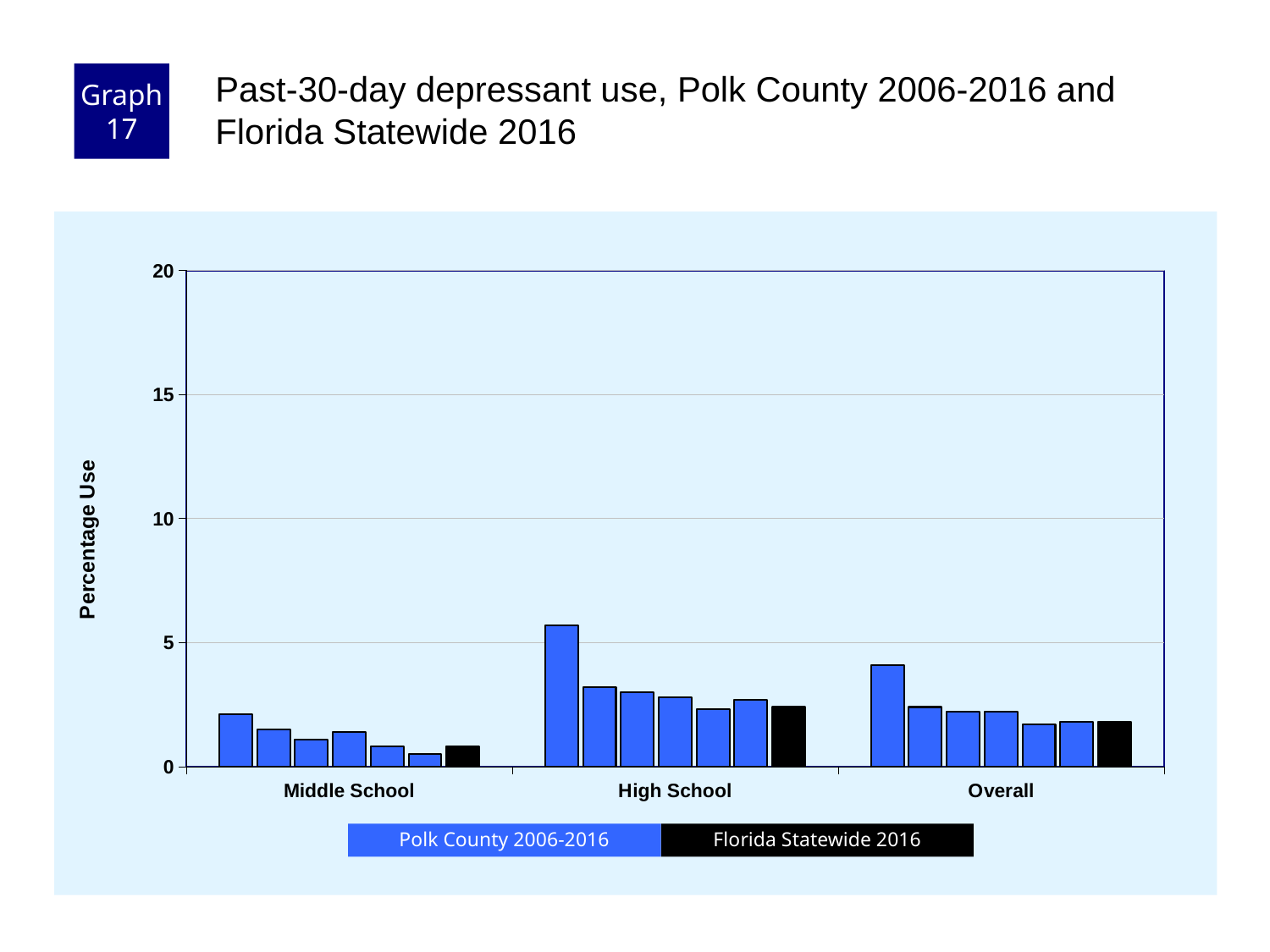
How many category groups are shown on the x axis? 3 Do the Polk County bars in the Middle School group generally rise or fall from left to right? fall Which category group contains the tallest bar? High School How many series does the legend list? 2 Which is larger: the Florida Statewide 2016 bar for High School or the Florida Statewide 2016 bar for Middle School? High School Which is larger: the first Polk County bar in the High School group or the first Polk County bar in the Overall group? High School What kind of chart is shown on the slide? bar chart Is the tallest bar in the Middle School group greater or less than 5? less Which series is shown in black according to the legend? Florida Statewide 2016 What is the label on the y axis? Percentage Use Is the Florida Statewide 2016 bar for Overall greater or less than 5? less Is the tallest bar in the High School group greater or less than 5? greater